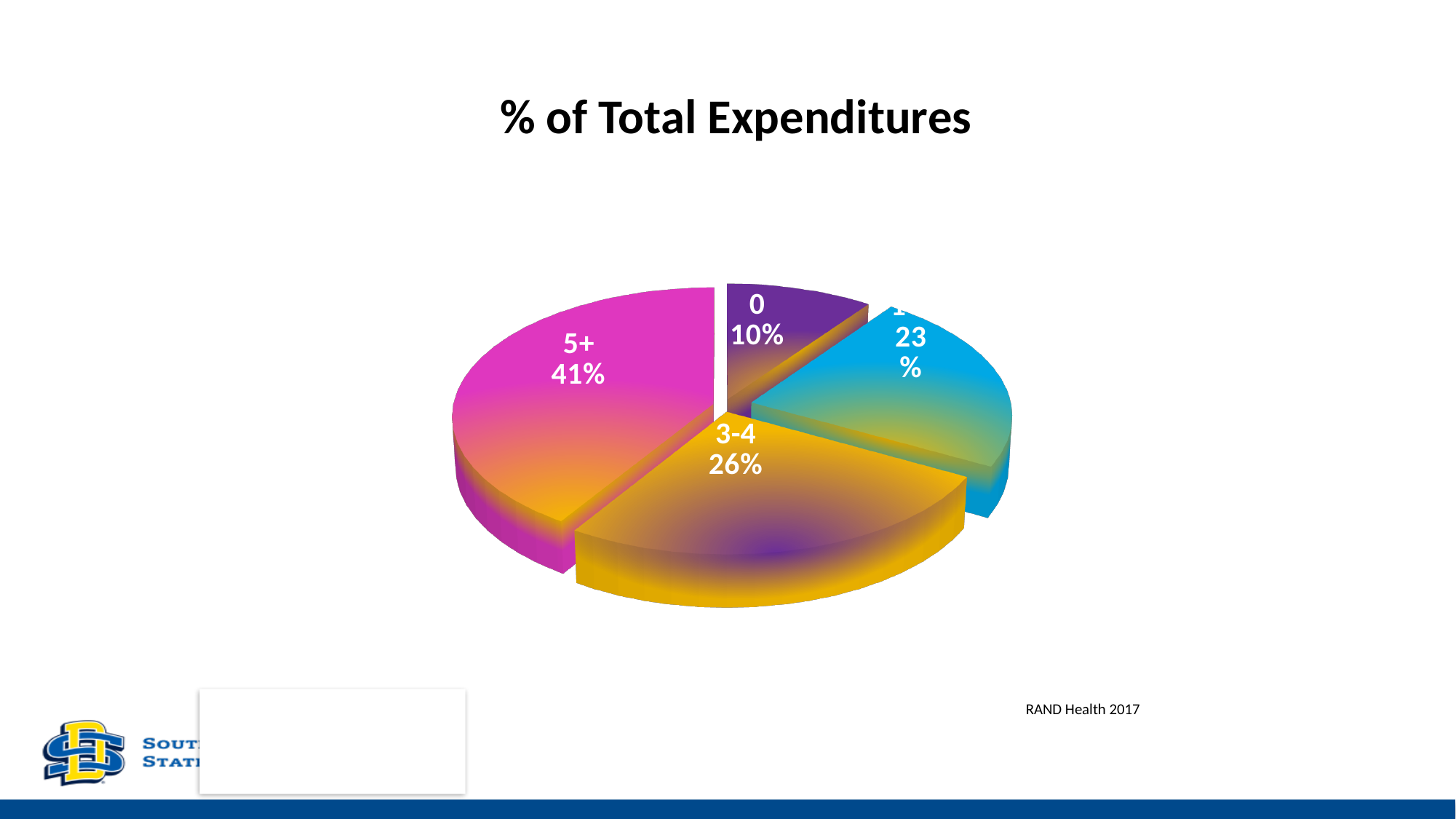
What percentage of total expenditures does the 3-4 slice represent? 26% Which slice has the largest share of total expenditures? 5+ What percentage of total expenditures does the 0 slice represent? 10% What percentage of total expenditures does the 5+ slice represent? 41% What source is cited at the bottom right of the slide? RAND Health 2017 Which slice is larger, 3-4 or 0? 3-4 What kind of chart is shown on the slide? pie chart How many percentage points larger is the 5+ slice than the 3-4 slice? 15 Which slice has the smallest share of total expenditures? 0 What is the title of the chart? % of Total Expenditures What percentage is shown on the blue slice of the pie? 23% How many slices does the pie chart have? 4